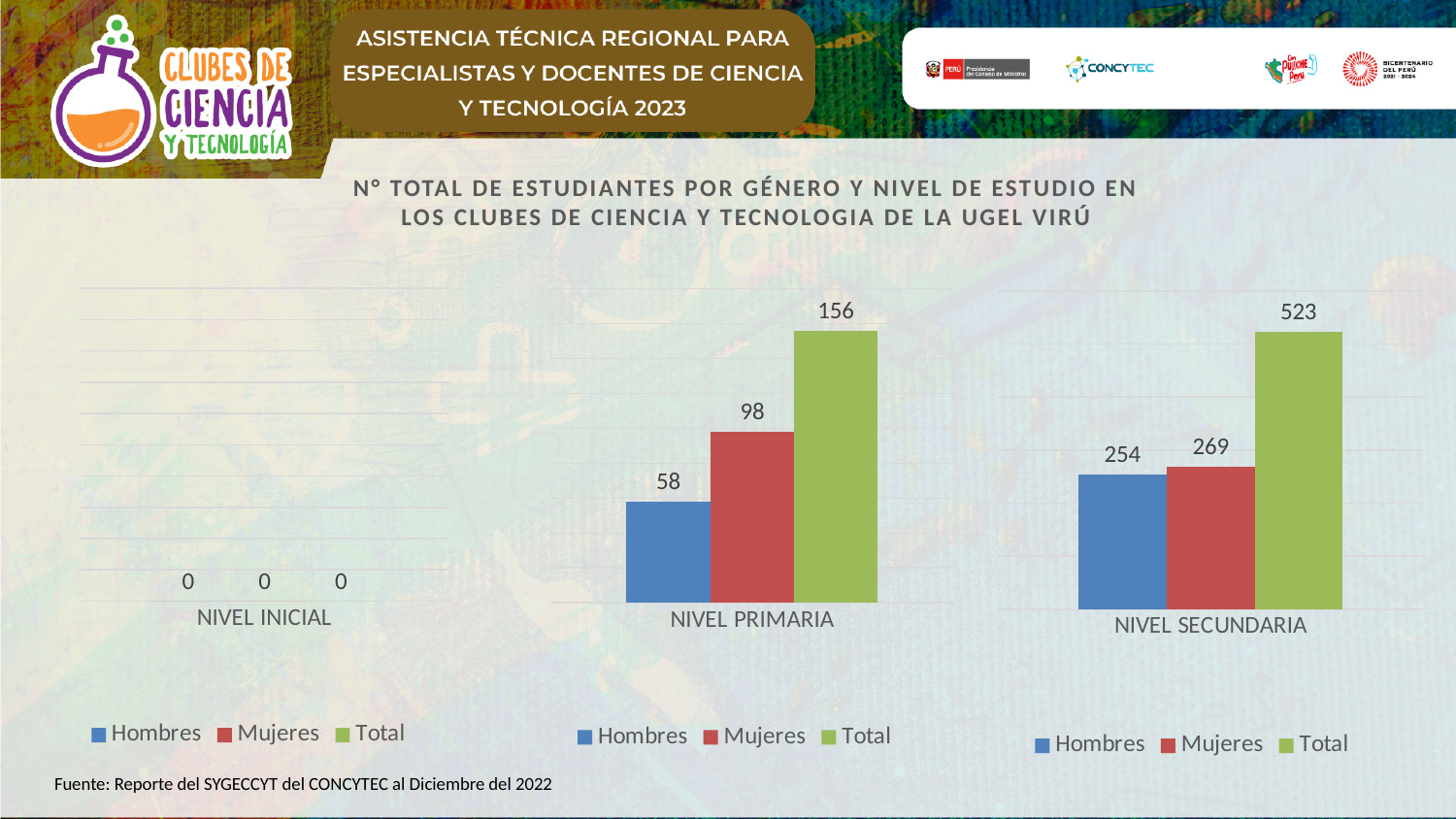
In the Nivel Secundaria chart, what is the value for Hombres? 254 In the Nivel Primaria chart, what is the value for Mujeres? 98 In the Nivel Secundaria chart, which series has the highest value? Total What kind of chart is the Nivel Primaria chart? Bar chart In the Nivel Primaria chart, what is the value for Hombres? 58 In the Nivel Inicial chart, what is the value for Mujeres? 0 In the Nivel Secundaria chart, which is larger, Hombres or Mujeres? Mujeres How many series does the legend of the Nivel Secundaria chart list? 3 In the Nivel Secundaria chart, what is the value for Total? 523 In the Nivel Primaria chart, which series has the lowest value? Hombres What colour represents the Total series in the charts? Green In the Nivel Primaria chart, what is the difference between Mujeres and Hombres? 40